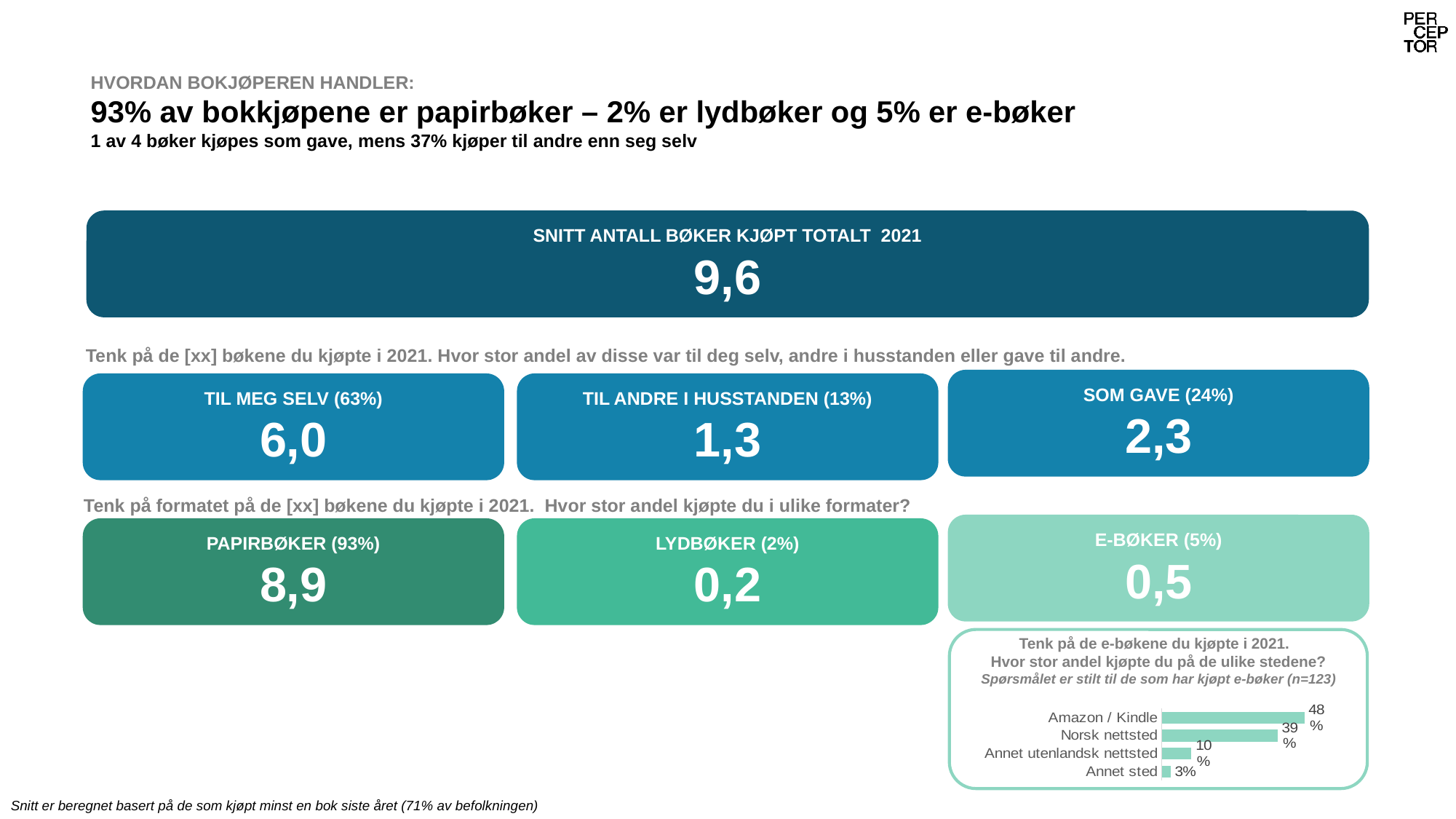
In the bar chart about where e-books were bought, which category has the highest value? Amazon / Kindle In the bar chart about where e-books were bought, which is larger: Annet utenlandsk nettsted or Annet sted? Annet utenlandsk nettsted In the bar chart about where e-books were bought, what is the value for Annet utenlandsk nettsted? 10% According to the note above the bar chart, how many respondents (n) answered the question about where e-books were bought? 123 What kind of chart is used to show where e-books were bought? Bar chart In the bar chart about where e-books were bought, which category has the lowest value? Annet sted In the bar chart about where e-books were bought, what is the value for Annet sted? 3% How many categories are shown in the bar chart about where e-books were bought? 4 In the bar chart about where e-books were bought, what is the difference between Amazon / Kindle and Norsk nettsted? 9 percentage points In the bar chart about where e-books were bought, what is the value for Amazon / Kindle? 48% In the bar chart about where e-books were bought, what is the value for Norsk nettsted? 39% In the bar chart about where e-books were bought, what is the difference between Norsk nettsted and Annet utenlandsk nettsted? 29 percentage points